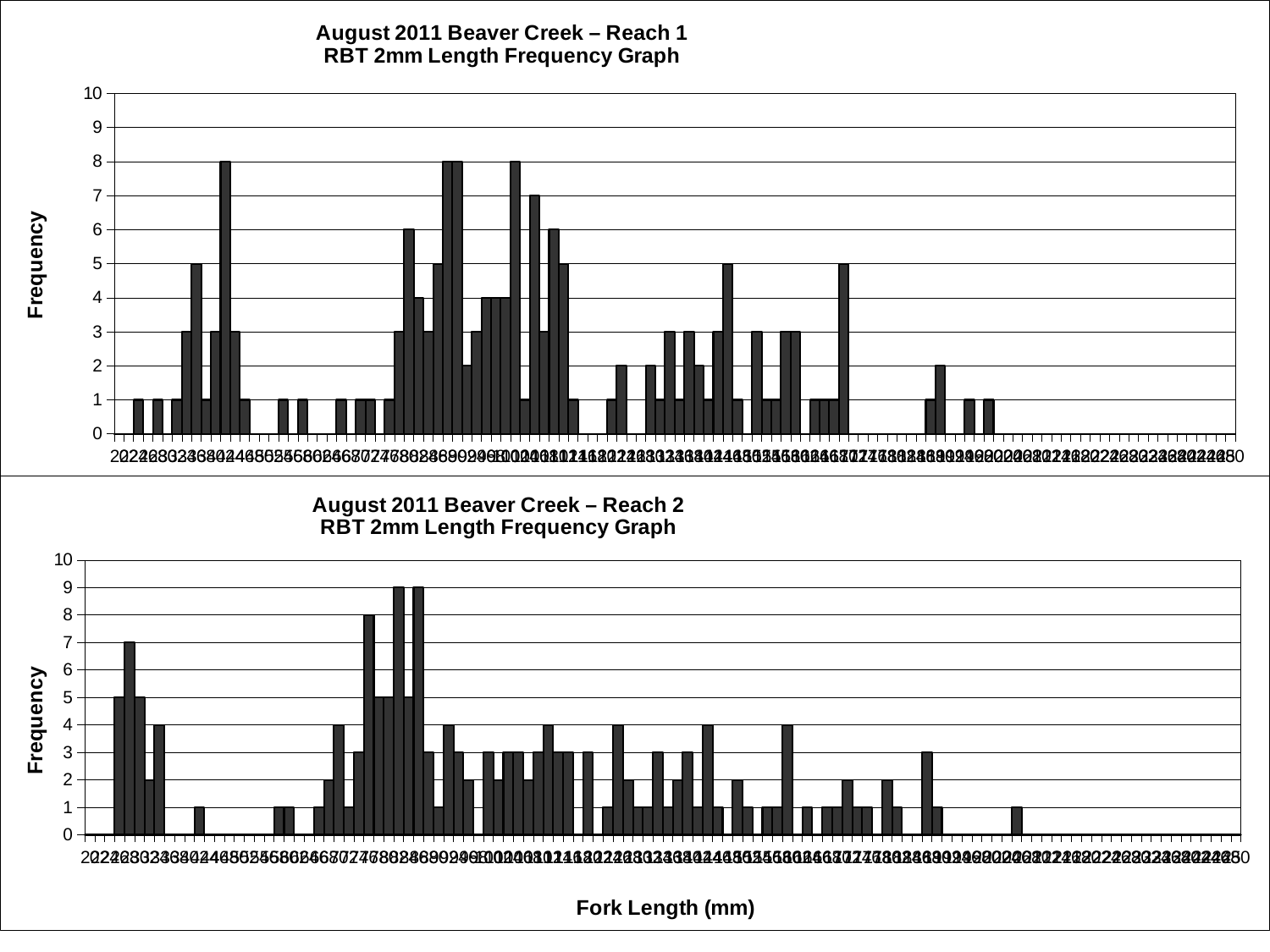
What type of chart is the "August 2011 Beaver Creek – Reach 2" chart? bar chart What is the maximum value shown on the y-axis of the Reach 1 chart? 10 In the "August 2011 Beaver Creek – Reach 2" chart, is the tallest bar greater or less than 8? greater What type of chart is the "August 2011 Beaver Creek – Reach 1" chart? bar chart Which chart has the taller tallest bar, the Reach 1 chart or the Reach 2 chart? Reach 2 What is the difference between the tallest bar in the Reach 2 chart and the tallest bar in the Reach 1 chart? 1 In the "August 2011 Beaver Creek – Reach 1" chart, is the tallest bar greater or less than 9? less What is the title of the x-axis shown below the Reach 2 chart? Fork Length (mm) In the "August 2011 Beaver Creek – Reach 1" chart, what is the highest frequency reached by any bar? 8 In the "August 2011 Beaver Creek – Reach 2" chart, what is the highest frequency reached by any bar? 9